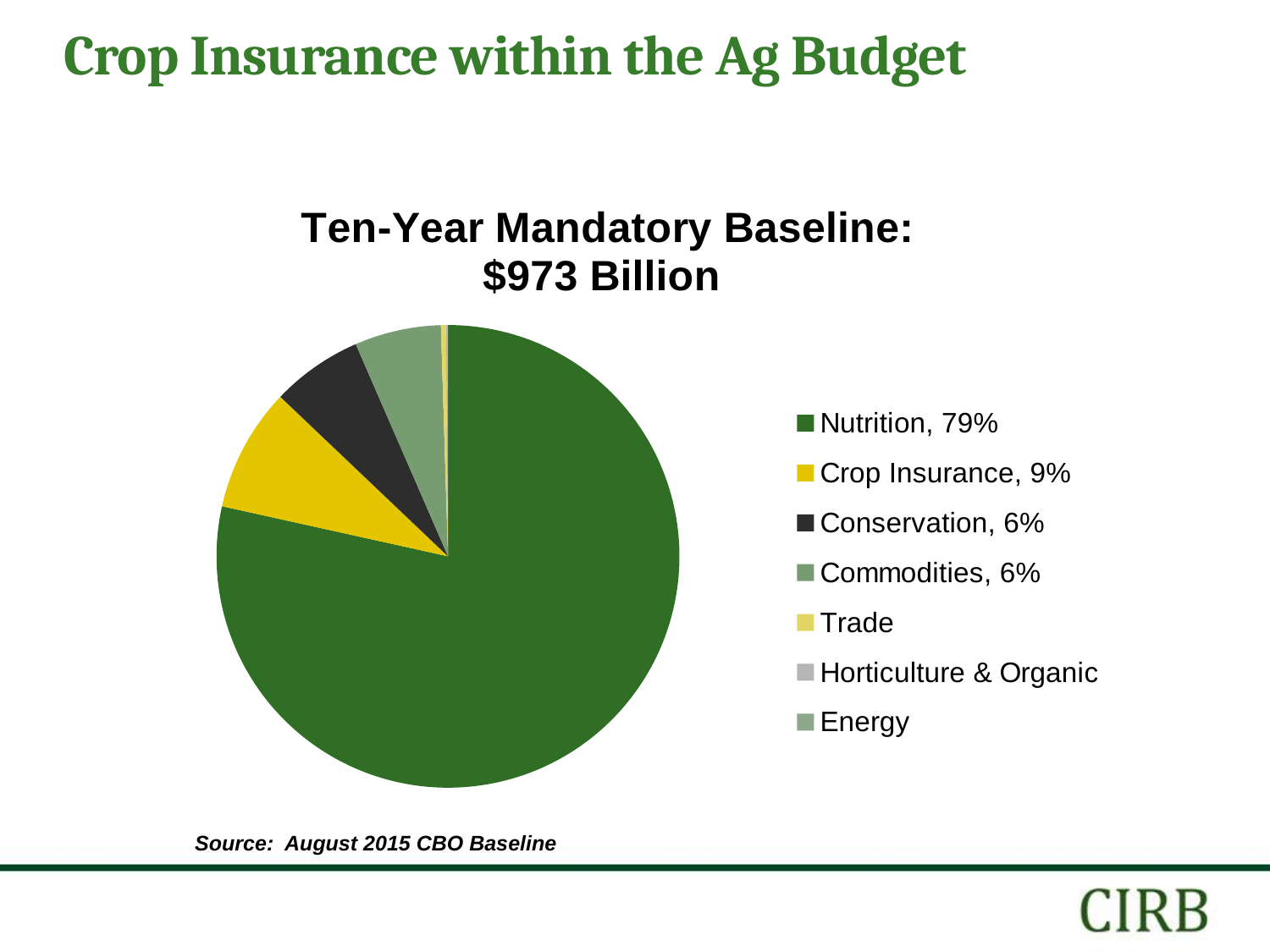
What share of the pie does Commodities represent? 6% Which category has the largest slice of the pie? Nutrition What source is cited below the chart? August 2015 CBO Baseline Which is larger, the share for Crop Insurance or the share for Conservation? Crop Insurance What share of the pie does Nutrition represent? 79% What is the combined share of Crop Insurance and Conservation? 15% How many categories does the legend list? 7 What is the title of the pie chart? Ten-Year Mandatory Baseline: $973 Billion What kind of chart is shown on the slide? Pie chart What share of the pie does Crop Insurance represent? 9% What is the difference in percentage points between Nutrition and Crop Insurance? 70